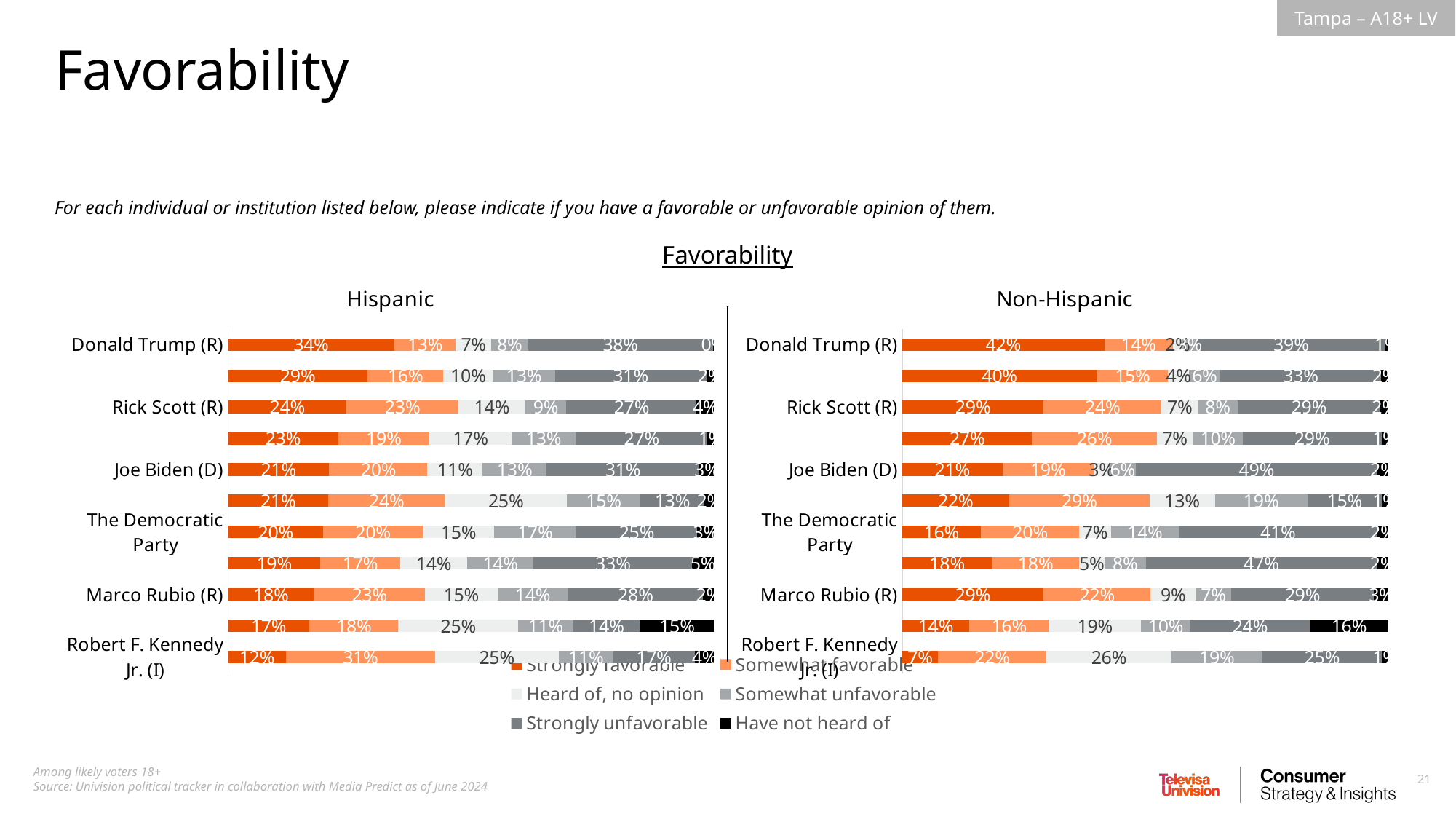
On the Non-Hispanic chart, what is the Strongly unfavorable value for Joe Biden (D)? 49% On the Hispanic chart, which labeled individual or institution has the highest Strongly favorable value? Donald Trump (R) On the Hispanic chart, what is the Strongly favorable value for Donald Trump (R)? 34% On the Hispanic chart, what is the Somewhat favorable value for Robert F. Kennedy Jr. (I)? 31% On the Non-Hispanic chart, which labeled individual or institution has the lowest Strongly favorable value? Robert F. Kennedy Jr. (I) On the Non-Hispanic chart, what is the Strongly favorable value for Donald Trump (R)? 42% On the Non-Hispanic chart, what is the Strongly unfavorable value for The Democratic Party? 41% What kind of chart is used on this slide? Stacked bar chart What is the difference between the Strongly favorable values for Donald Trump (R) on the Non-Hispanic chart and on the Hispanic chart? 8% How many series does the legend list? 6 On the Hispanic chart, is the Strongly unfavorable value for Donald Trump (R) larger or smaller than that for Joe Biden (D)? larger On the Hispanic chart, what is the Heard of, no opinion value for Rick Scott (R)? 14%